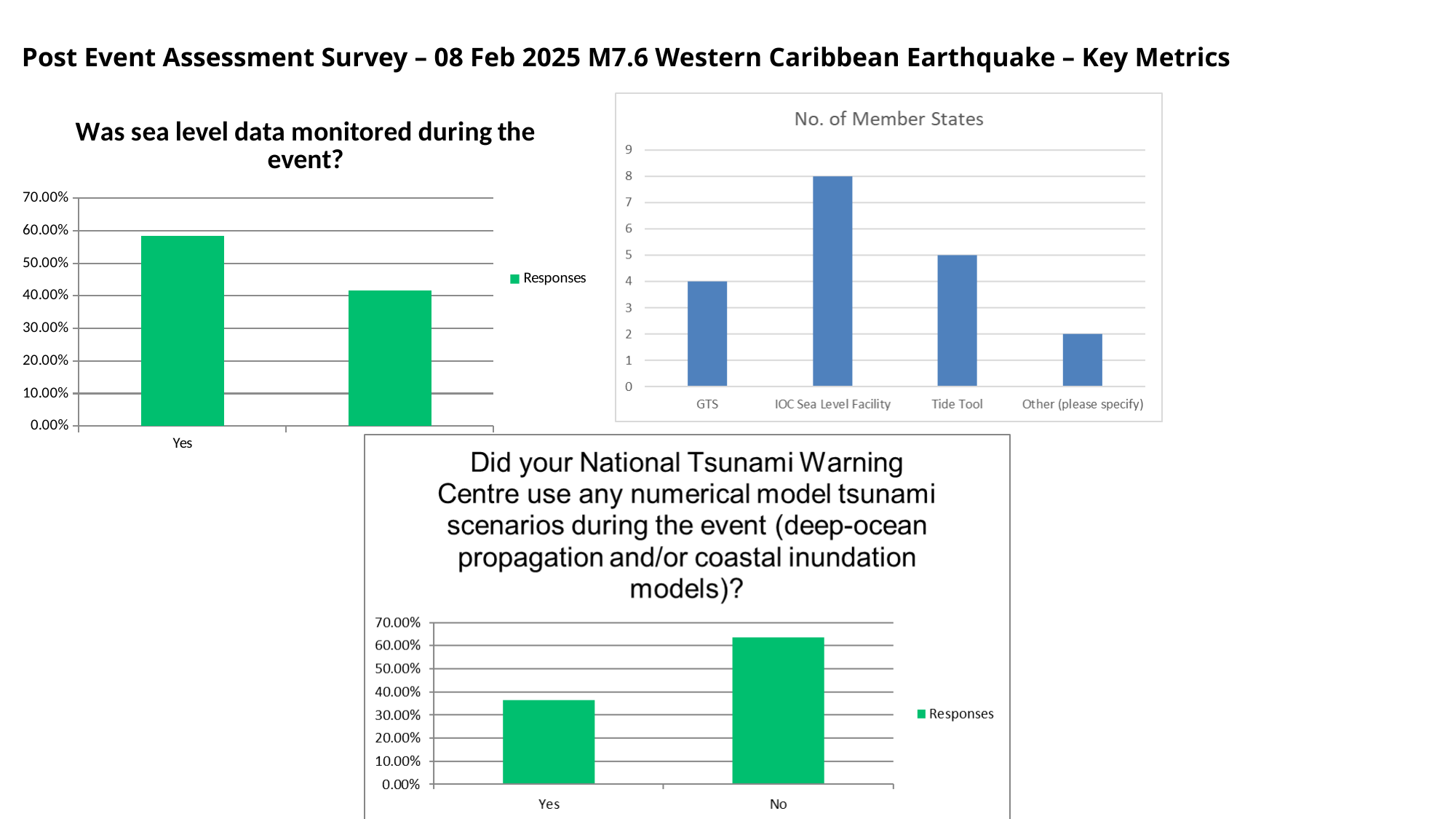
In the 'No. of Member States' chart, what is the value for IOC Sea Level Facility? 8 In the 'No. of Member States' chart, which category has the lowest value? Other (please specify) In the chart 'Was sea level data monitored during the event?', is the value for Yes greater or less than 50.00%? greater In the 'No. of Member States' chart, what is the value for GTS? 4 How many categories are shown in the 'No. of Member States' chart? 4 In the chart 'Did your National Tsunami Warning Centre use any numerical model tsunami scenarios during the event...?', is the value for Yes greater or less than 40.00%? less In the 'No. of Member States' chart, what is the difference between IOC Sea Level Facility and GTS? 4 In the 'No. of Member States' chart, what is the value for Tide Tool? 5 What series name does the legend show in the chart 'Did your National Tsunami Warning Centre use any numerical model tsunami scenarios during the event...?' Responses What kind of chart is the 'No. of Member States' chart? bar chart In the 'No. of Member States' chart, which category has the highest value? IOC Sea Level Facility In the chart 'Did your National Tsunami Warning Centre use any numerical model tsunami scenarios during the event...?', which is larger, Yes or No? No